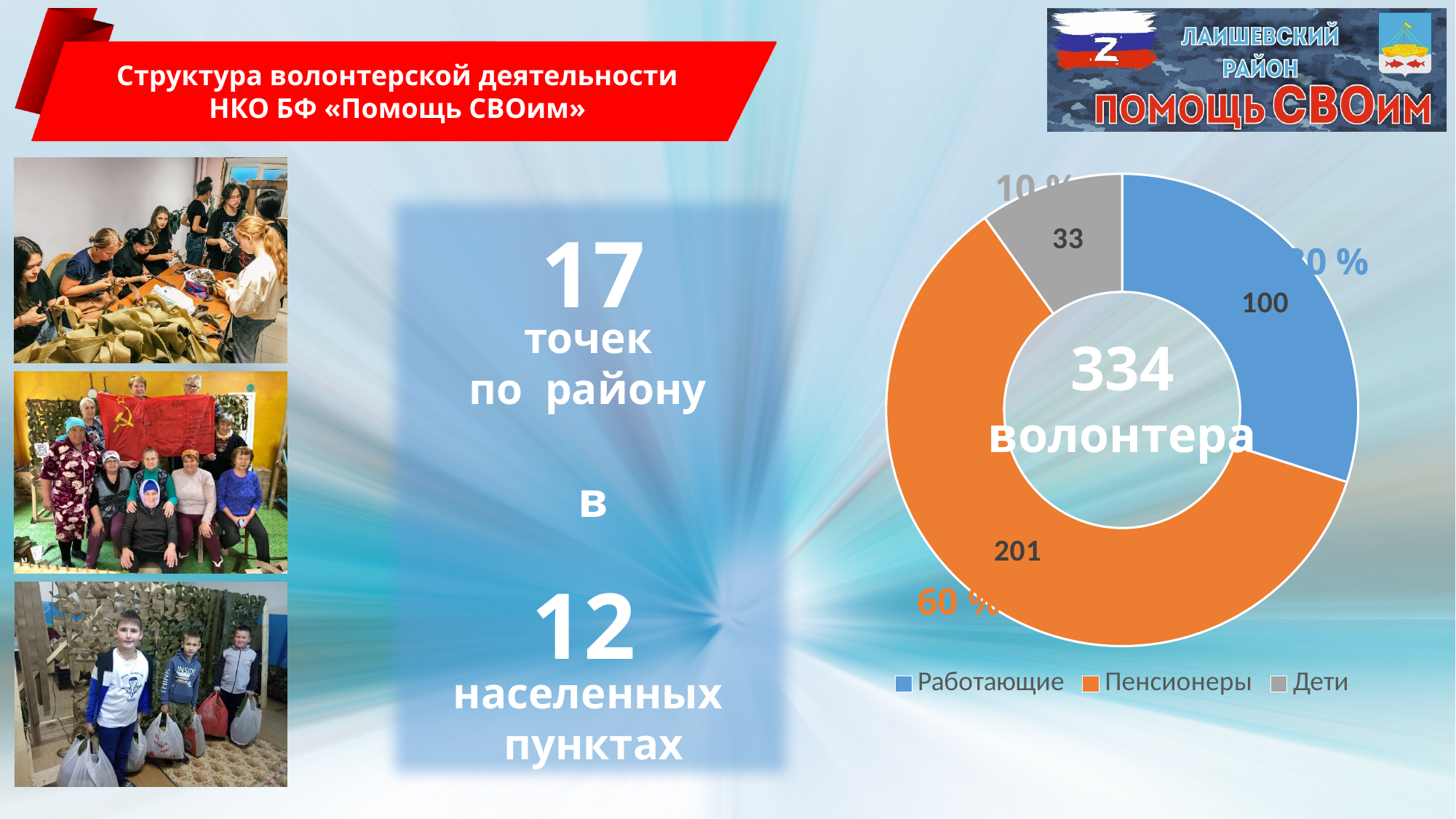
How many volunteers are in the Пенсионеры category? 201 How many categories does the chart show? 3 Which category has the smallest number of volunteers? Дети How many volunteers are in the Дети category? 33 What is the difference between the Пенсионеры and Работающие values? 101 How many entries does the legend list? 3 What kind of chart is shown on the slide? doughnut chart Which category has the largest number of volunteers? Пенсионеры What is the total number of volunteers shown in the centre of the chart? 334 волонтера How many volunteers are in the Работающие category? 100 Which is larger, the value for Работающие or the value for Дети? Работающие What percentage share is labelled for the Дети slice? 10 %